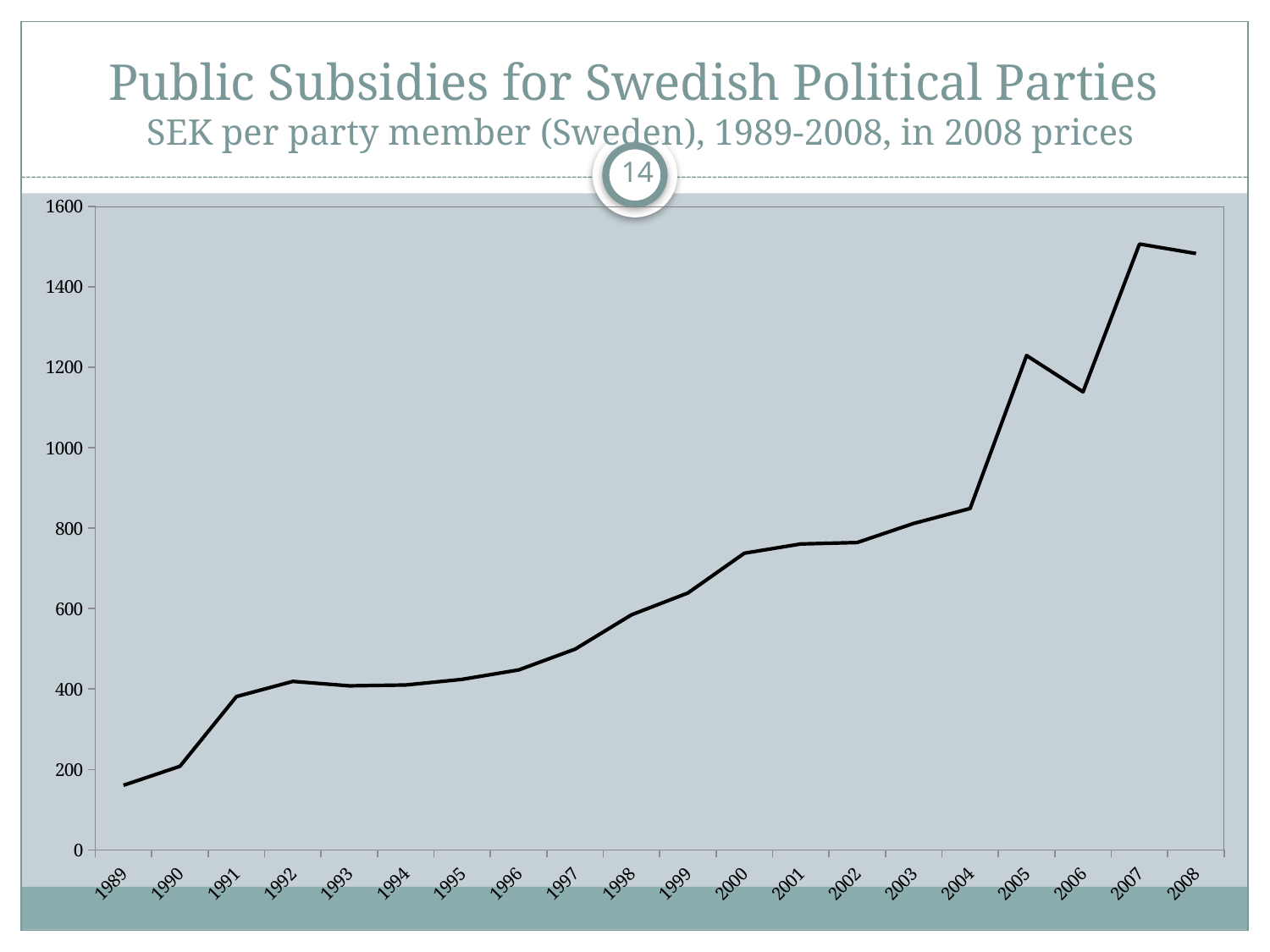
Is the value for 2004 greater or less than 800? greater Which year has the larger value, 2005 or 2006? 2005 Overall, do the values rise or fall from 1989 to 2008? rise Is the value for 1996 greater or less than 600? less What kind of chart is shown on the slide? line chart Which year has the lowest value? 1989 What is the title of the chart? Public Subsidies for Swedish Political Parties Is the value for 1989 greater or less than 200? less Which year has the larger value, 1991 or 1999? 1999 How many years are plotted along the x axis? 20 Which year has the highest value? 2007